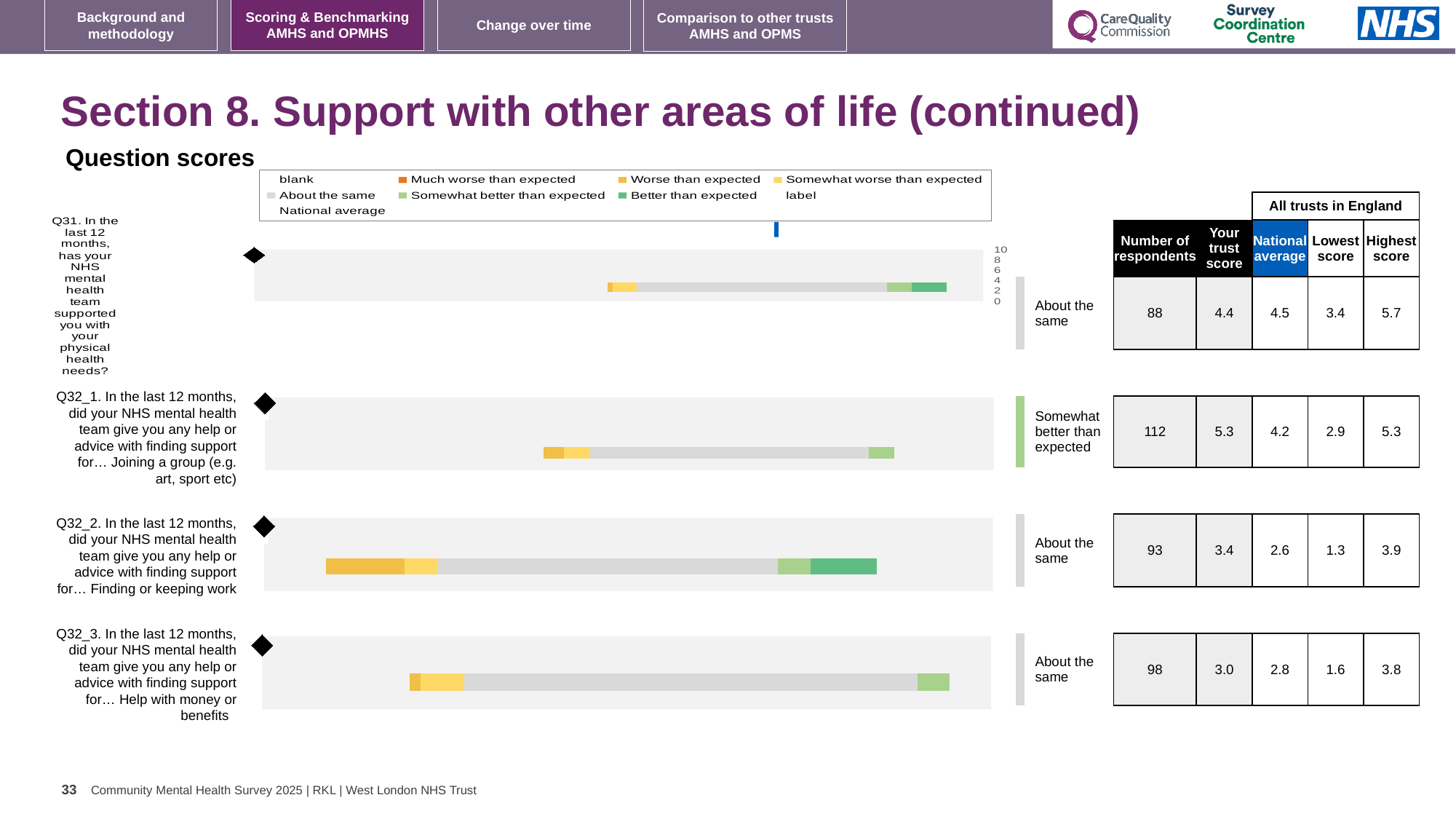
How many question rows (charts) are shown on the slide? 4 Which question row has the highest 'Your trust score'? Q32_1 (Joining a group) What kind of chart is used to show the question scores for Q31 on this slide? bar chart For the Q32_3 chart (help with money or benefits), how many respondents are shown? 98 For the Q32_1 chart (help with joining a group), what is the national average shown? 4.2 Which question row has the lowest 'Your trust score'? Q32_3 (Help with money or benefits) For the Q32_2 chart (finding or keeping work), what is the highest score among all trusts in England? 3.9 For the Q32_2 chart (finding or keeping work), what is the difference between the trust score and the national average? 0.8 What colour represents 'Better than expected' in the chart legend? Green For the Q31 chart, which is larger: the trust score or the national average? National average What comparison label is shown next to the Q32_1 chart (joining a group)? Somewhat better than expected For the Q31 chart (support with physical health needs), what is the trust's score shown in the table? 4.4